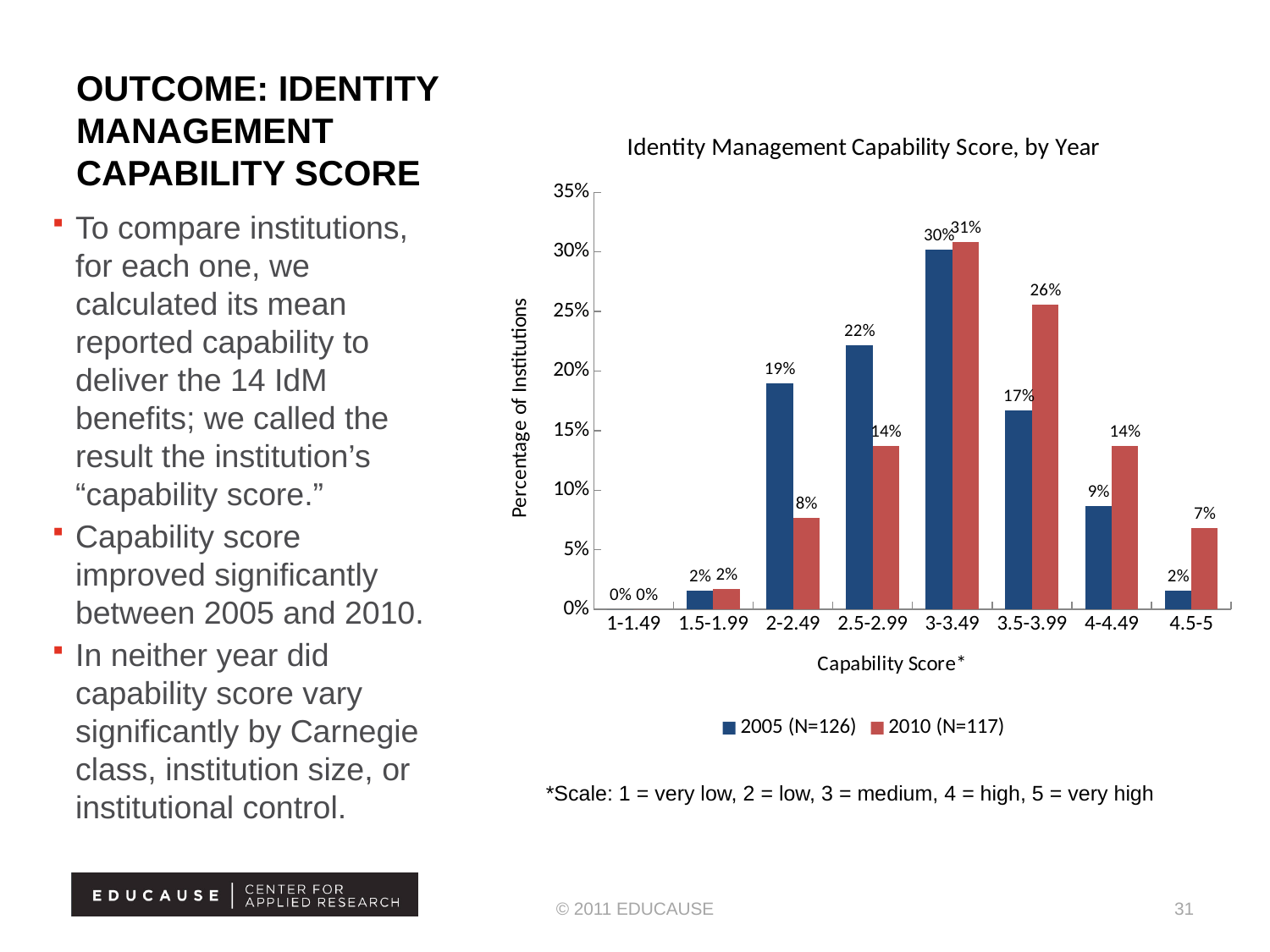
What is the value for 2010 (N=117) in the 4.5-5 category? 7% Which capability score category has the highest value for 2010 (N=117)? 3-3.49 How many series does the chart's legend list? 2 What is the difference between the 2005 (N=126) and 2010 (N=117) values for the 2.5-2.99 category? 8% What is the title of the chart? Identity Management Capability Score, by Year What type of chart is shown on the slide? bar chart For the 4-4.49 category, which series has the larger value, 2005 (N=126) or 2010 (N=117)? 2010 (N=117) What percentage of institutions had a capability score of 3.5-3.99 in 2010 (N=117)? 26% Which capability score category has the lowest value for 2005 (N=126)? 1-1.49 How many capability score categories are shown on the x axis? 8 What is the label of the y axis? Percentage of Institutions What percentage of institutions had a capability score of 2-2.49 in 2005 (N=126)? 19%